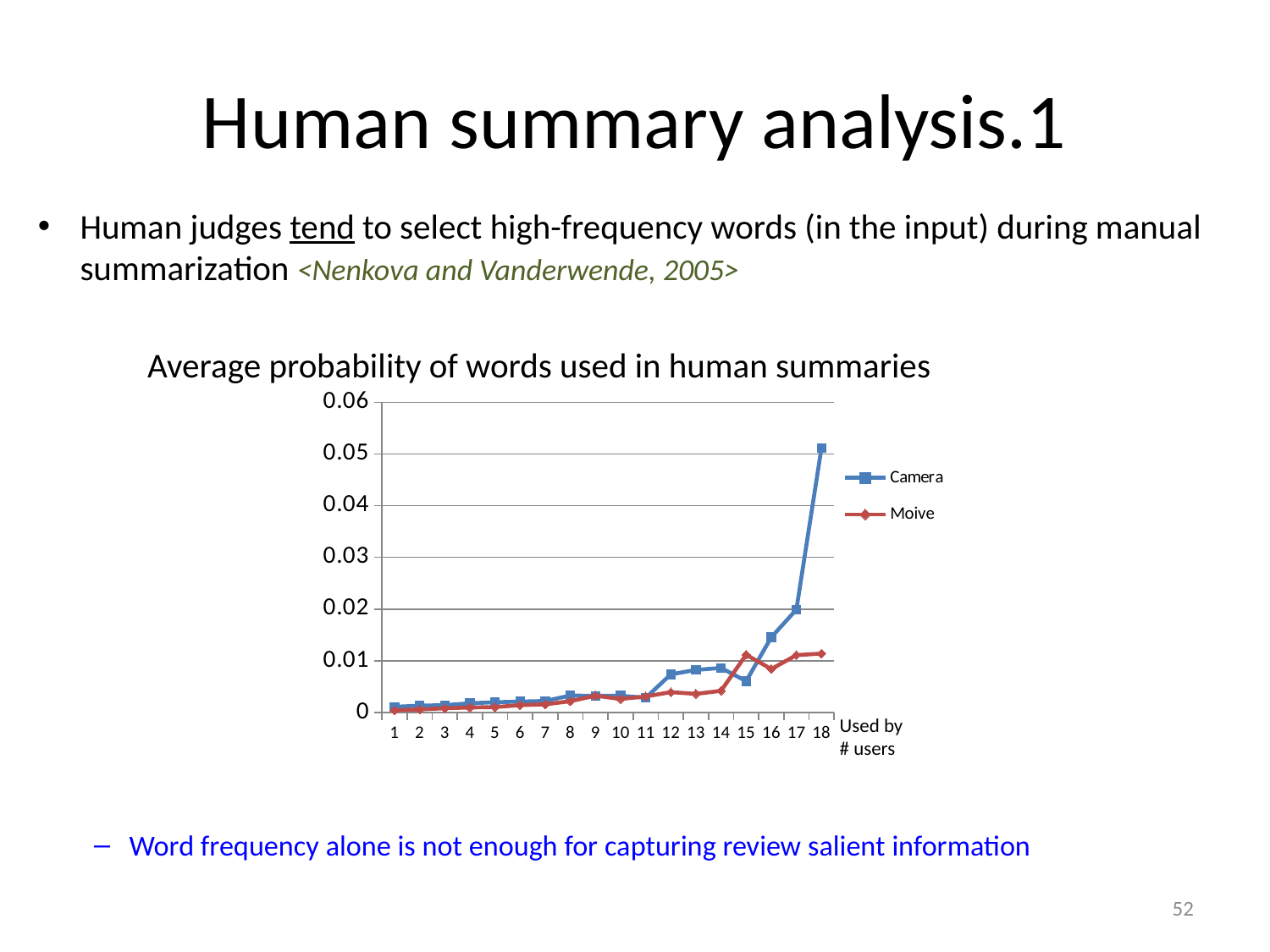
What kind of chart is shown on the slide? line chart Is the value for Camera at x = 16 greater or less than 0.02? less Is the value for Camera at x = 18 greater or less than 0.04? greater How many points along the x axis does each series have? 18 Is the value for Moive at x = 18 greater or less than 0.02? less At x = 18, which series has the larger value, Camera or Moive? Camera How many series does the chart legend list? 2 Do the values of the Camera series generally rise or fall as the x axis goes from 1 to 18? rise Which series reaches the highest value on the chart? Camera What is the title of the chart? Average probability of words used in human summaries At x = 15, which series has the larger value, Camera or Moive? Moive What are the two series named in the chart legend? Camera and Moive